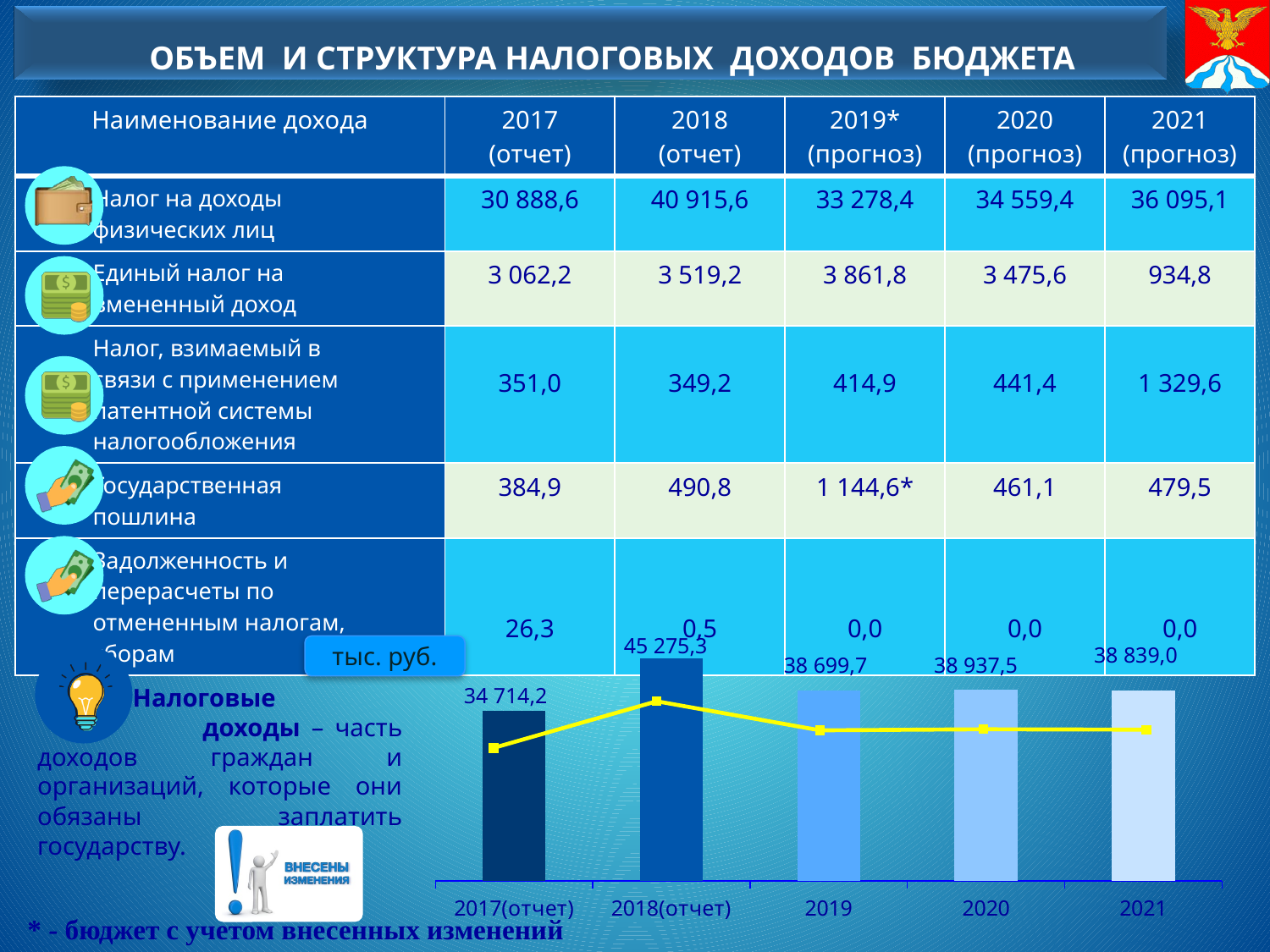
In the bar chart at the bottom of the slide, which year has the lowest value? 2017(отчет) In the bar chart at the bottom of the slide, what is the value for 2019? 38 699,7 In the bar chart at the bottom of the slide, what is the value for 2021? 38 839,0 In the bar chart at the bottom of the slide, which year has the highest value? 2018(отчет) In the bar chart at the bottom of the slide, what is the value for 2018(отчет)? 45 275,3 What unit is indicated for the values in the chart at the bottom of the slide? тыс. руб. In the bar chart at the bottom of the slide, what is the value for 2020? 38 937,5 In the bar chart at the bottom of the slide, which is larger: the value for 2018(отчет) or the value for 2021? 2018(отчет) In the chart at the bottom of the slide, does the value rise or fall from 2018(отчет) to 2019? fall In the bar chart at the bottom of the slide, what is the value for 2017(отчет)? 34 714,2 How many bars are shown in the bar chart at the bottom of the slide? 5 In the bar chart at the bottom of the slide, what is the difference between the values for 2018(отчет) and 2017(отчет)? 10 561,1